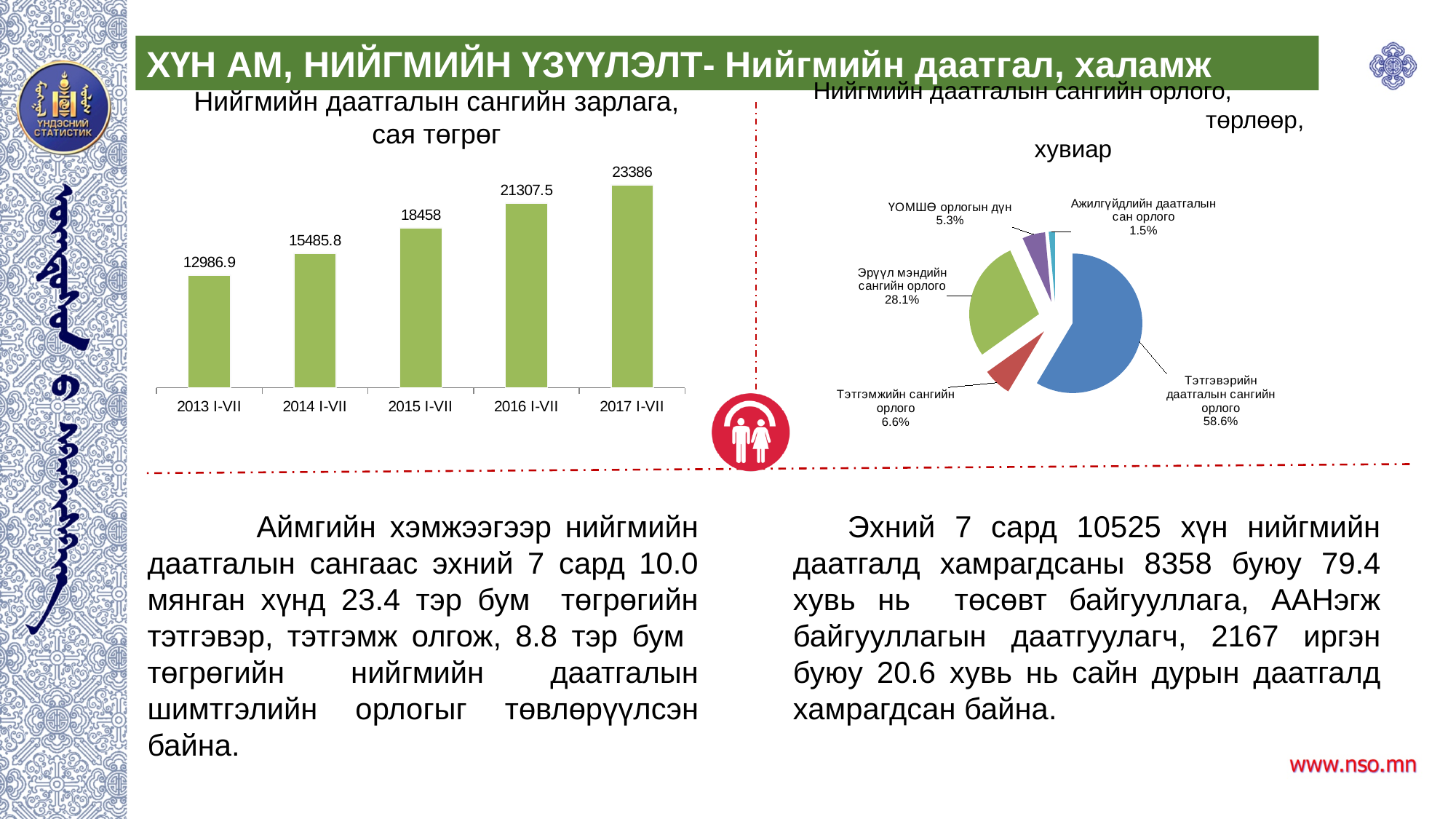
In the left chart 'Нийгмийн даатгалын сангийн зарлага, сая төгрөг', what is the difference between the values for 2017 I-VII and 2016 I-VII? 2078.5 What kind of chart is the left chart 'Нийгмийн даатгалын сангийн зарлага, сая төгрөг'? bar chart In the right pie chart 'Нийгмийн даатгалын сангийн орлого, төрлөөр, хувиар', which category has the smallest share? Ажилгүйдлийн даатгалын сан орлого In the left chart 'Нийгмийн даатгалын сангийн зарлага, сая төгрөг', how many periods are shown? 5 In the left chart 'Нийгмийн даатгалын сангийн зарлага, сая төгрөг', what is the value for 2015 I-VII? 18458 In the left chart 'Нийгмийн даатгалын сангийн зарлага, сая төгрөг', which period has the lowest value? 2013 I-VII In the left chart 'Нийгмийн даатгалын сангийн зарлага, сая төгрөг', what is the value for 2013 I-VII? 12986.9 In the right pie chart 'Нийгмийн даатгалын сангийн орлого, төрлөөр, хувиар', how many slices are there? 5 In the right pie chart 'Нийгмийн даатгалын сангийн орлого, төрлөөр, хувиар', which category has the largest share? Тэтгэврийн даатгалын сангийн орлого In the right pie chart 'Нийгмийн даатгалын сангийн орлого, төрлөөр, хувиар', what share does 'Эрүүл мэндийн сангийн орлого' have? 28.1% In the left chart 'Нийгмийн даатгалын сангийн зарлага, сая төгрөг', do the values rise or fall from 2013 I-VII to 2017 I-VII? rise In the left chart 'Нийгмийн даатгалын сангийн зарлага, сая төгрөг', which period has the highest value? 2017 I-VII